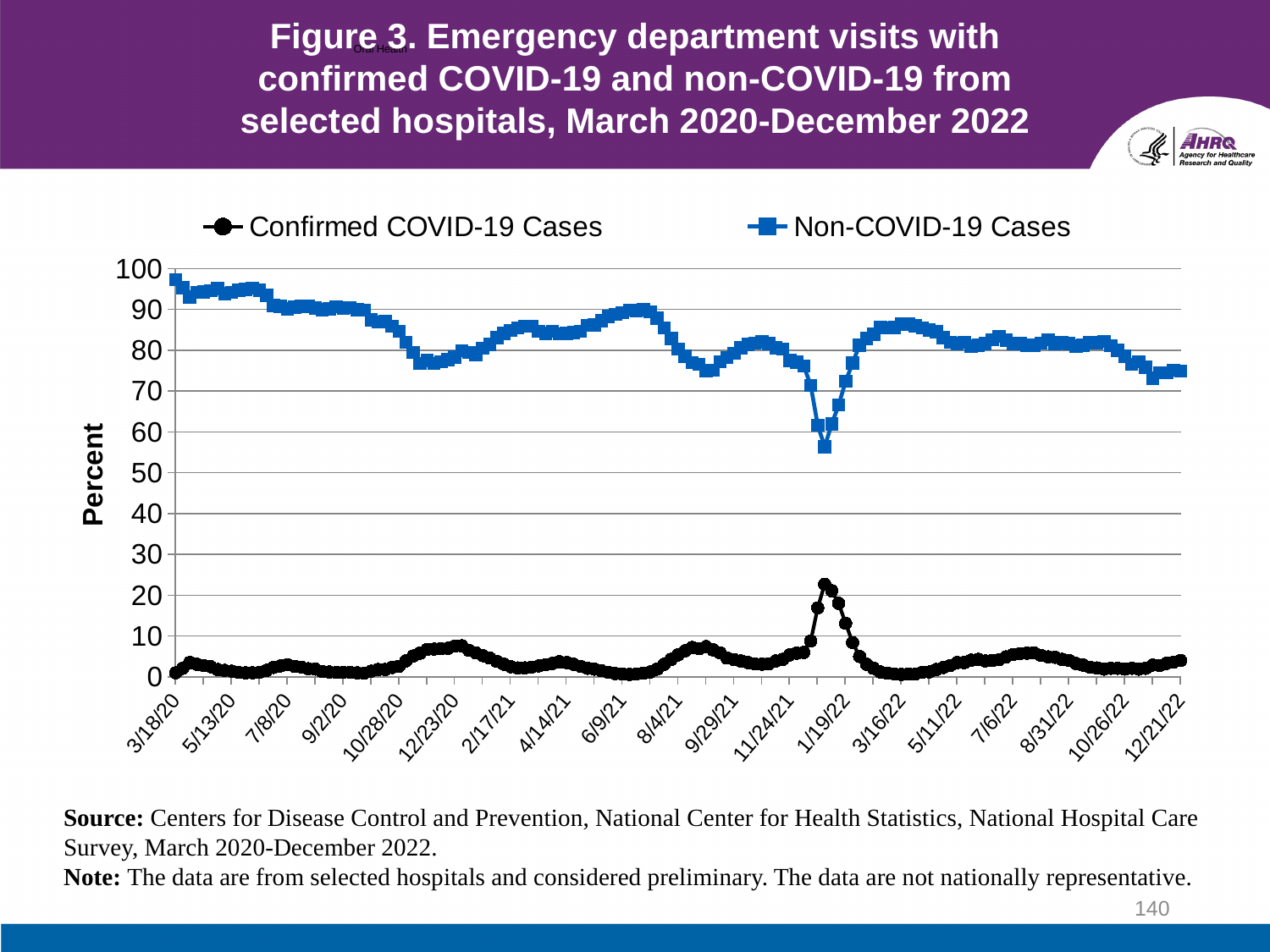
Does the Confirmed COVID-19 Cases line rise or fall between 11/24/21 and 1/19/22? Rise Is the highest value reached by the Confirmed COVID-19 Cases line (around 1/19/22) greater or less than 10? greater Is the value for Confirmed COVID-19 Cases at 3/18/20 greater or less than 10? less Is the lowest value reached by the Non-COVID-19 Cases line (around 1/19/22) greater or less than 70? less How many series does the legend list? 2 What is the label on the vertical axis? Percent Which series has the higher value at 6/9/21, Confirmed COVID-19 Cases or Non-COVID-19 Cases? Non-COVID-19 Cases What are the two series named in the legend? Confirmed COVID-19 Cases and Non-COVID-19 Cases What kind of chart is shown on the slide? Line chart How many date labels are shown on the x axis? 19 Does the Non-COVID-19 Cases line rise or fall between 3/18/20 and 10/28/20? Fall